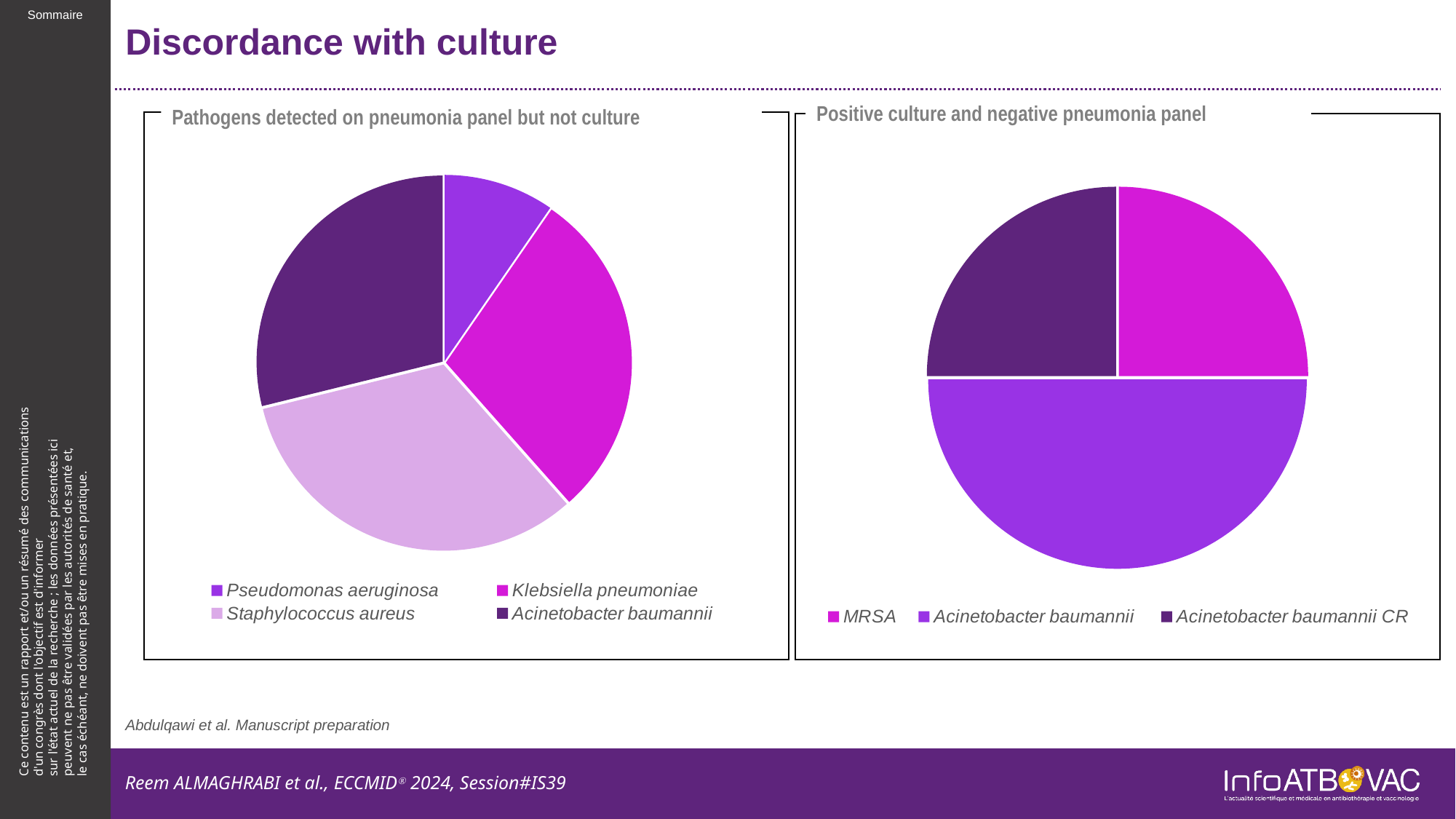
How many entries does the legend of the 'Positive culture and negative pneumonia panel' chart list? 3 In the 'Pathogens detected on pneumonia panel but not culture' chart, which slice is larger: Staphylococcus aureus or Pseudomonas aeruginosa? Staphylococcus aureus What is the title of the chart on the left of the slide? Pathogens detected on pneumonia panel but not culture In the 'Pathogens detected on pneumonia panel but not culture' chart, which pathogen has the smallest slice? Pseudomonas aeruginosa In the 'Positive culture and negative pneumonia panel' chart, which slice is larger: MRSA or Acinetobacter baumannii? Acinetobacter baumannii In the 'Pathogens detected on pneumonia panel but not culture' chart, how many slices does the pie have? 4 In the 'Positive culture and negative pneumonia panel' chart, how many slices does the pie have? 3 What kind of chart is the 'Positive culture and negative pneumonia panel' chart? pie chart In the 'Pathogens detected on pneumonia panel but not culture' chart, which slice is larger: Pseudomonas aeruginosa or Klebsiella pneumoniae? Klebsiella pneumoniae In the 'Positive culture and negative pneumonia panel' chart, which category has the largest slice? Acinetobacter baumannii What kind of chart is the 'Pathogens detected on pneumonia panel but not culture' chart? pie chart In the 'Pathogens detected on pneumonia panel but not culture' chart, which pathogen is shown in the light lavender colour? Staphylococcus aureus